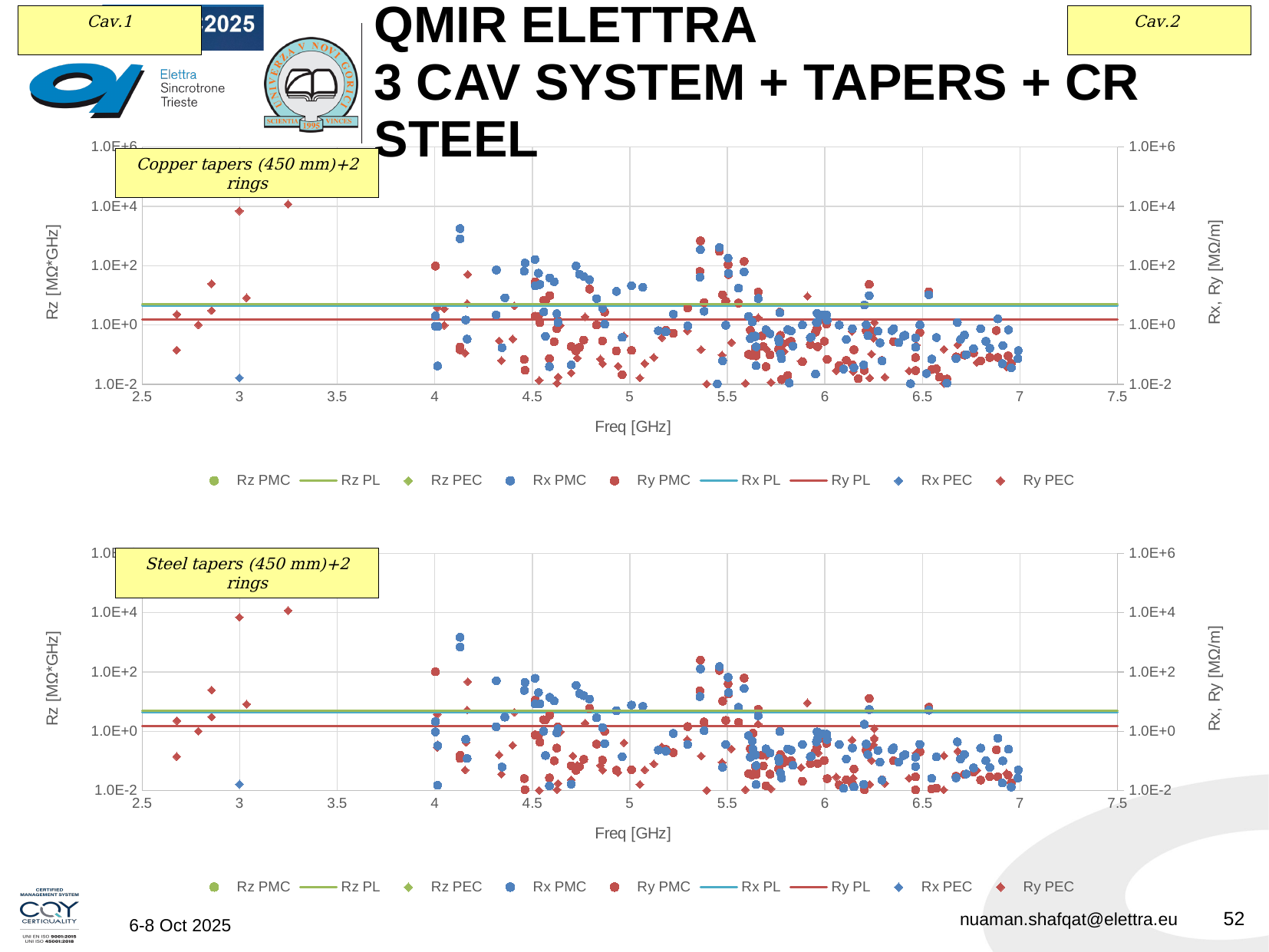
In the top chart 'Copper tapers (450 mm)+2 rings', which is larger: the Rz PL line or the Ry PL line? Rz PL In the top chart 'Copper tapers (450 mm)+2 rings', what is the label of the x axis? Freq [GHz] What kind of chart is the top chart titled 'Copper tapers (450 mm)+2 rings'? scatter chart In the top chart 'Copper tapers (450 mm)+2 rings', is the Rz PL horizontal line greater or less than 1.0E+0? greater In the top chart 'Copper tapers (450 mm)+2 rings', is the Ry PEC point near 3.25 GHz greater or less than 1.0E+2? greater In the top chart 'Copper tapers (450 mm)+2 rings', is the Rz PL horizontal line greater or less than 1.0E+2? less In the bottom chart 'Steel tapers (450 mm)+2 rings', what is the label of the left y axis? Rz [MΩ*GHz] How many series does the legend of the bottom chart 'Steel tapers (450 mm)+2 rings' list? 9 In the bottom chart 'Steel tapers (450 mm)+2 rings', which is larger: the Rz PL line or the Ry PL line? Rz PL